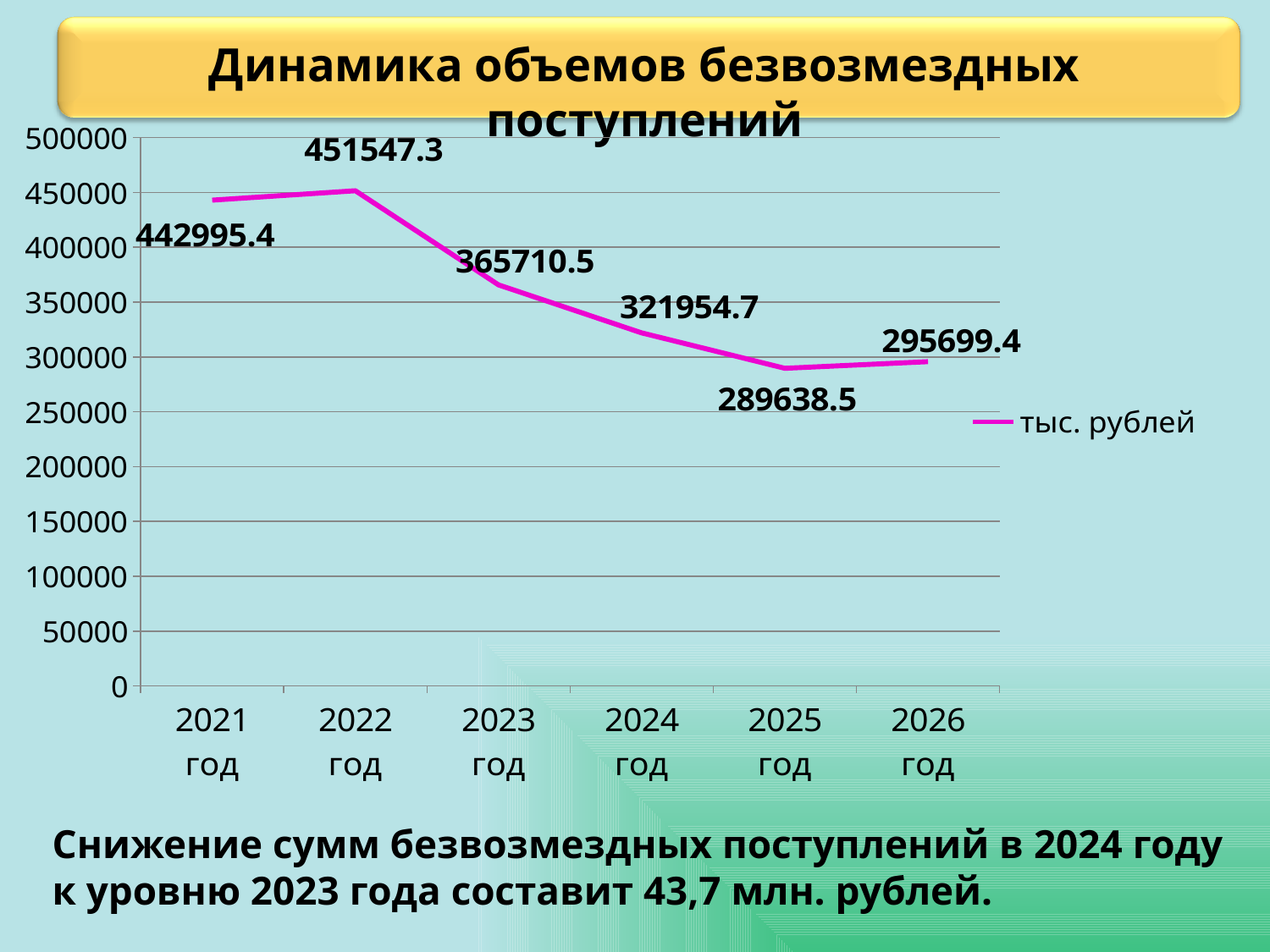
Is the value for 2023 год greater or less than 350000? greater What is the difference between the values for 2023 год and 2024 год? 43755.8 How many years are plotted on the chart? 6 Which year has the lowest value? 2025 год What is the value for 2022 год? 451547.3 What is the legend entry for the plotted series? тыс. рублей What is the difference between the values for 2022 год and 2021 год? 8551.9 What is the value for 2024 год? 321954.7 Which year has the highest value? 2022 год What is the value for 2025 год? 289638.5 What kind of chart is shown on the slide? line chart Which is larger, the value for 2026 год or the value for 2025 год? 2026 год